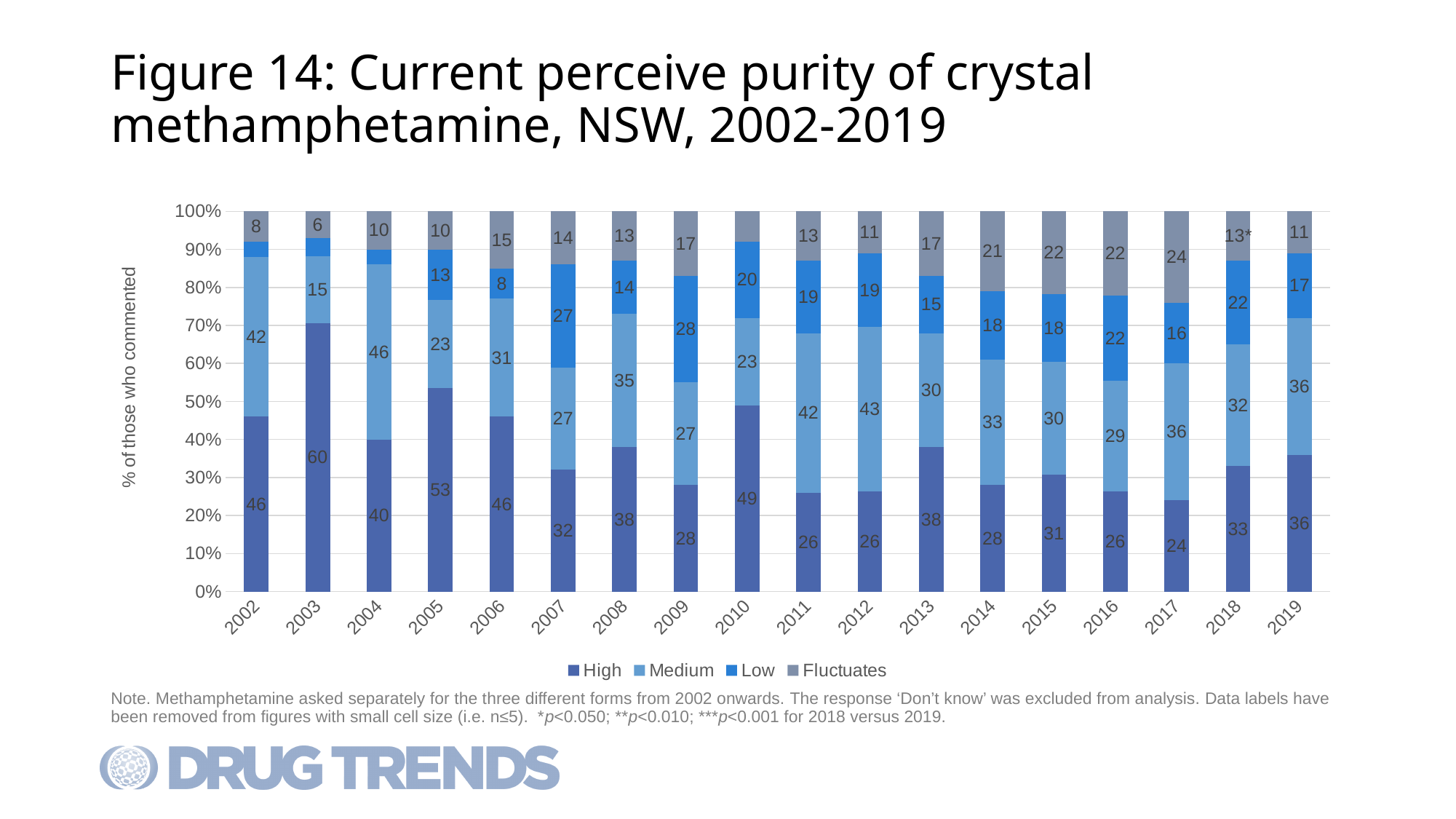
What is the value for Fluctuates in 2017? 24 What kind of chart is shown on the slide? Stacked bar chart What is the difference between the High values for 2010 and 2011? 23 What is the value for Low in 2019? 17 How many years are shown on the x axis? 18 In which year was the High share the smallest? 2017 Which is larger, the Medium value in 2004 or the Medium value in 2006? 2004 How many series does the legend list? 4 What are the four legend entries of the chart? High, Medium, Low, Fluctuates What is the value for Medium in 2012? 43 In which year was the High share the largest? 2003 What percentage of those who commented rated the purity as High in 2005? 53